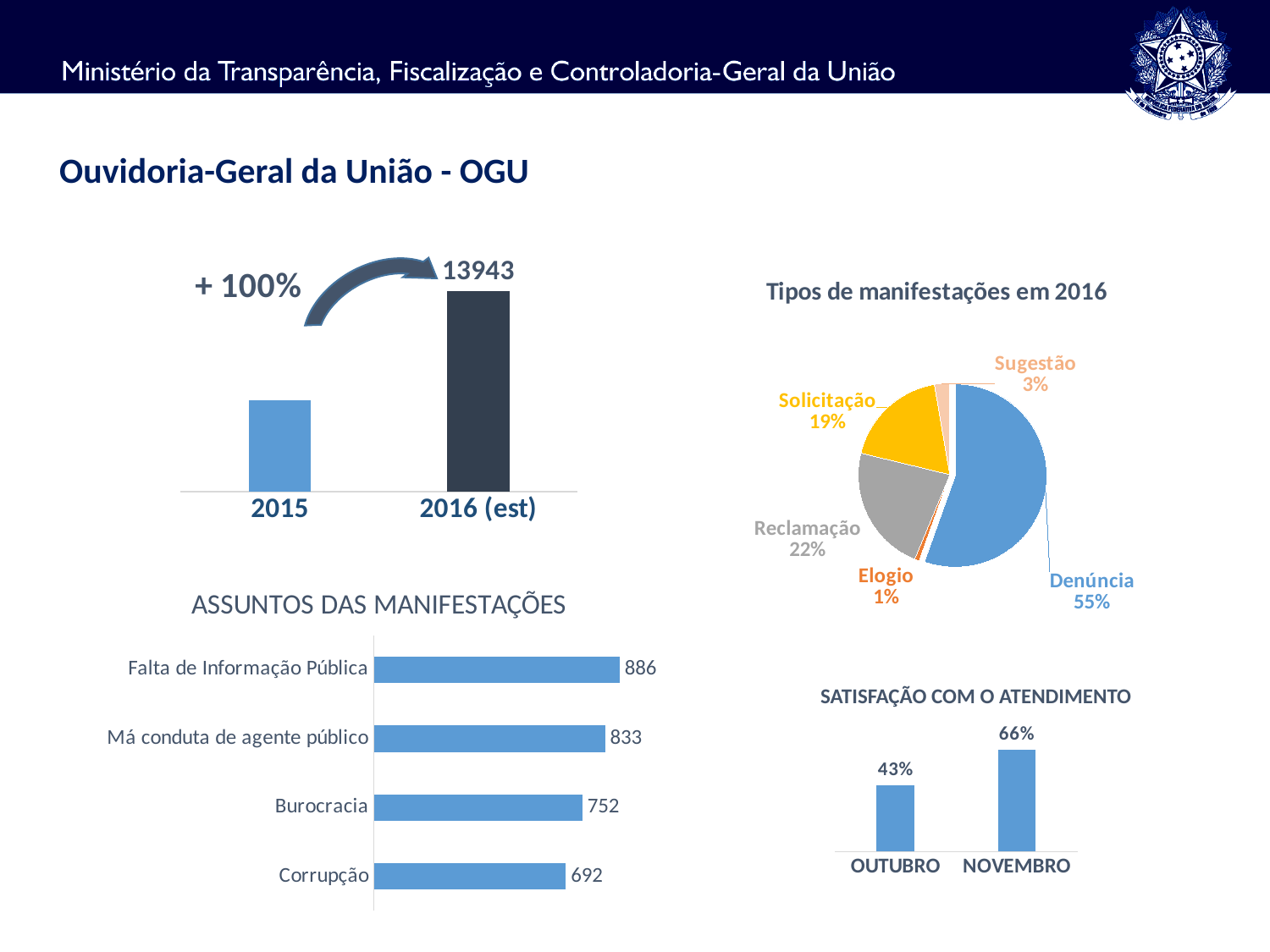
In the 'ASSUNTOS DAS MANIFESTAÇÕES' chart, what is the difference between Falta de Informação Pública and Corrupção? 194 In the 'Tipos de manifestações em 2016' pie chart, what share does Denúncia have? 55% In the 'Tipos de manifestações em 2016' pie chart, what is the difference in percentage points between Reclamação and Solicitação? 3 In the 'SATISFAÇÃO COM O ATENDIMENTO' chart, what is the value for NOVEMBRO? 66% In the 'ASSUNTOS DAS MANIFESTAÇÕES' chart, which category has the highest value? Falta de Informação Pública In the top-left bar chart, which year has the higher bar, 2015 or 2016 (est)? 2016 (est) In the top-left bar chart, what is the value shown for 2016 (est)? 13943 In the 'ASSUNTOS DAS MANIFESTAÇÕES' chart, what is the value for Burocracia? 752 In the 'Tipos de manifestações em 2016' pie chart, how many categories are shown? 5 In the 'SATISFAÇÃO COM O ATENDIMENTO' chart, do the values rise or fall from OUTUBRO to NOVEMBRO? Rise In the 'Tipos de manifestações em 2016' pie chart, which category has the smallest slice? Elogio What kind of chart is 'ASSUNTOS DAS MANIFESTAÇÕES'? Bar chart